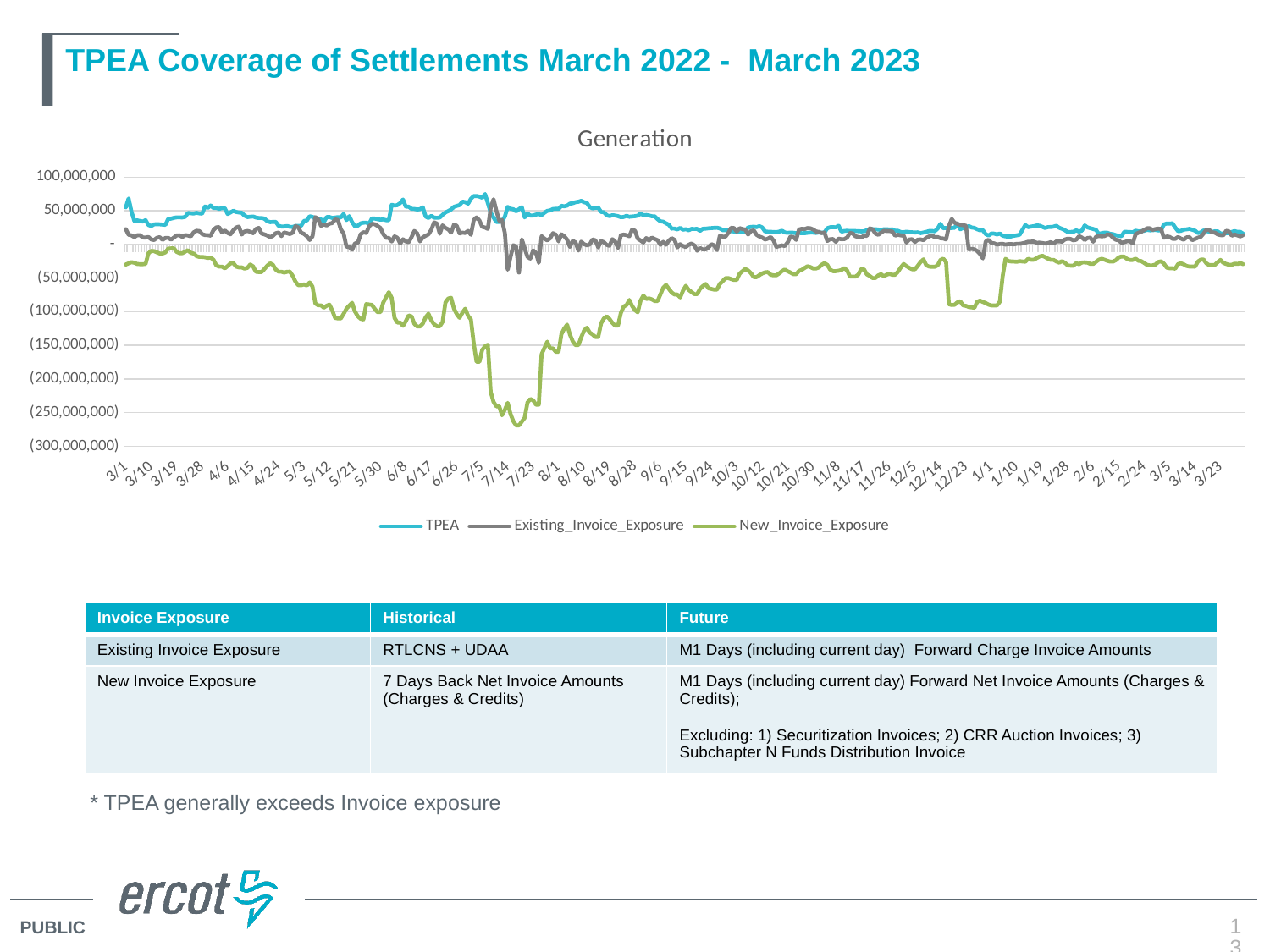
Is the value of TPEA around 11/8 greater or less than 50,000,000? less Around 7/23, which is larger: the TPEA value or the New_Invoice_Exposure value? TPEA What is the lowest value shown on the vertical axis of the chart? (300,000,000) What colour is the New_Invoice_Exposure line in the chart? green Does the New_Invoice_Exposure line rise or fall between 7/23 and 9/24? rise Is the lowest value of New_Invoice_Exposure (around 7/23) greater or less than (200,000,000)? less What kind of chart is shown on the slide? line chart Which series reaches the lowest value on the chart? New_Invoice_Exposure How many series does the chart legend list? 3 What is the title of the chart? Generation Which series is generally the highest across the chart? TPEA